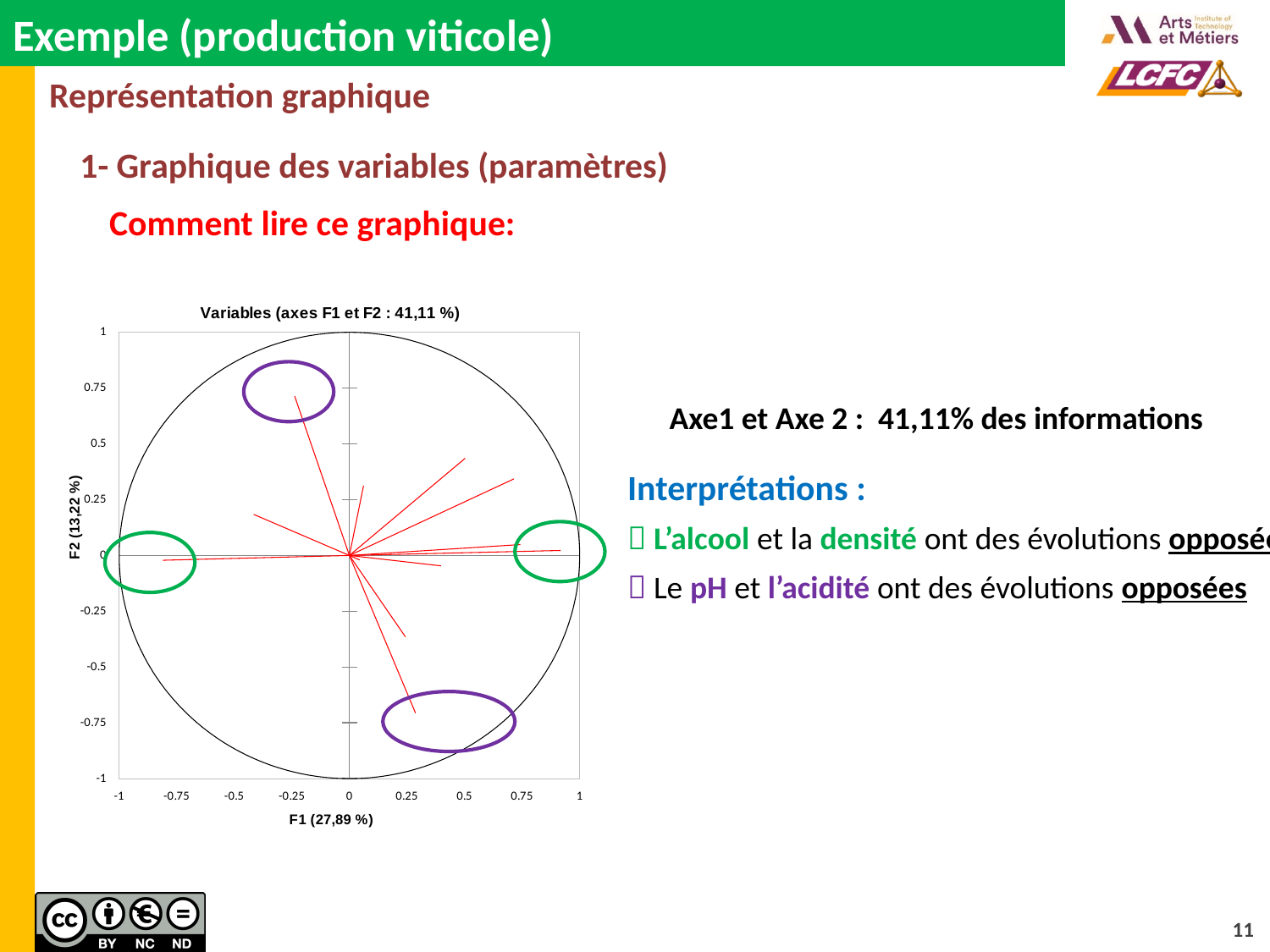
Is the F2 value of the vector inside the bottom purple ellipse greater or less than -0.5? less What is the highest tick value shown on the horizontal axis of the chart? 1 What is the difference between the percentage shown for F1 and the percentage shown for F2? 14,67 % According to the chart title, what percentage of information do axes F1 and F2 together represent? 41,11 % What is the lowest tick value shown on the vertical axis of the chart? -1 Is the F2 value of the vector inside the top purple ellipse greater or less than 0.5? greater Which axis of the chart carries a larger percentage, F1 or F2? F1 What colour are the variable vectors drawn from the origin in the chart? red What is the title of the chart on the slide? Variables (axes F1 et F2 : 41,11 %) What percentage is shown in the horizontal axis label F1 of the chart? 27,89 % What is the sum of the percentages shown for F1 and F2 on the chart axes? 41,11 % What percentage is shown in the vertical axis label F2 of the chart? 13,22 %